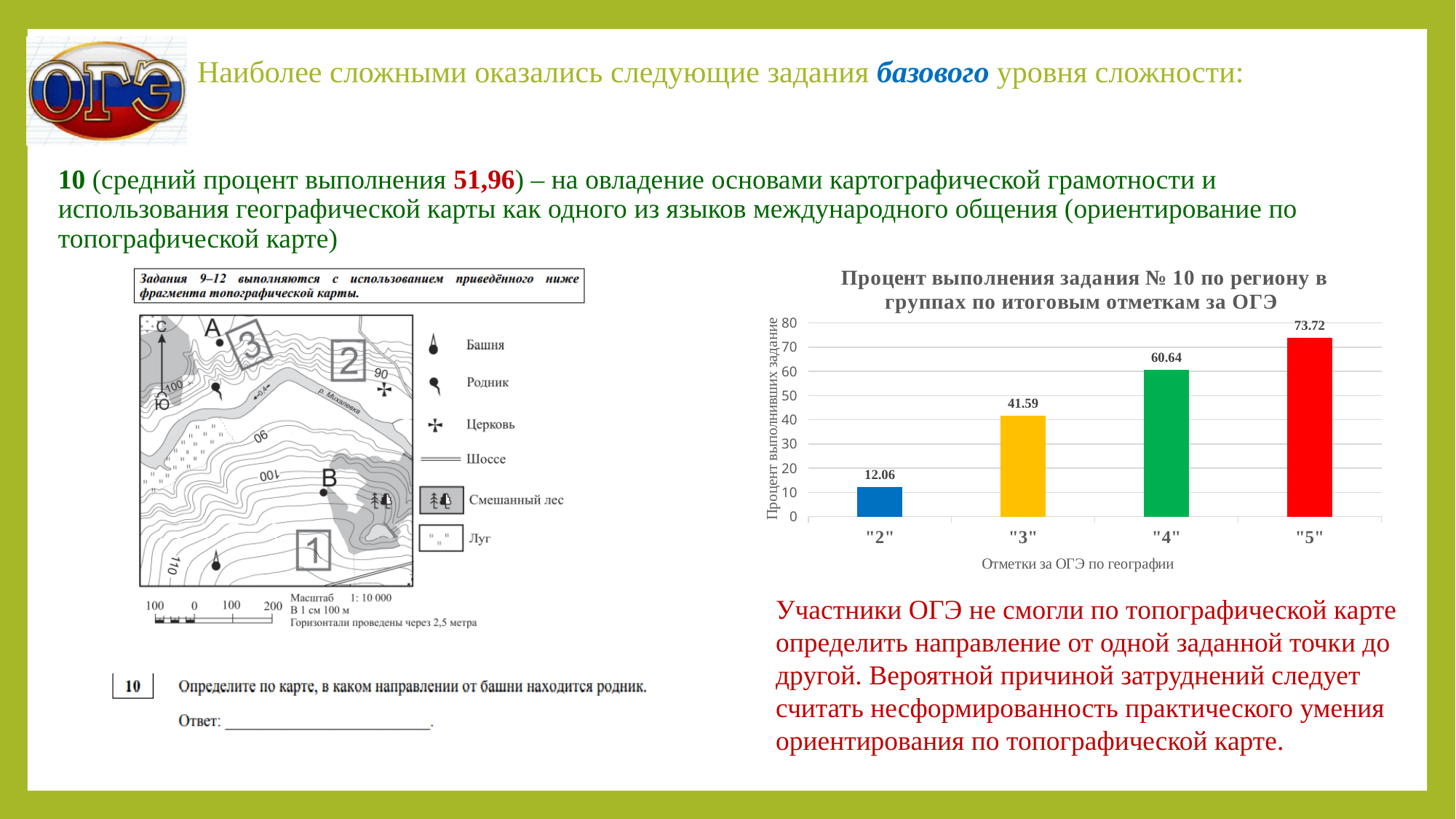
What kind of chart is used to show the completion percentage of task 10? bar chart What is the difference between the values for the "5" group and the "4" group? 13.08 Which group has a larger value, "3" or "4"? "4" What value is shown for the group with the mark "4"? 60.64 What value is shown for the group with the mark "5"? 73.72 What is the difference between the values for the "3" group and the "2" group? 29.53 Which mark group has the highest completion percentage for task 10? "5" Is the value for the "3" group greater or less than 50? less Which mark group has the lowest completion percentage for task 10? "2" How many mark groups are shown on the x axis of the chart? 4 What is the percentage of students who completed task 10 in the group with the final mark "2"? 12.06 Do the values rise or fall as the marks increase from "2" to "5"? rise